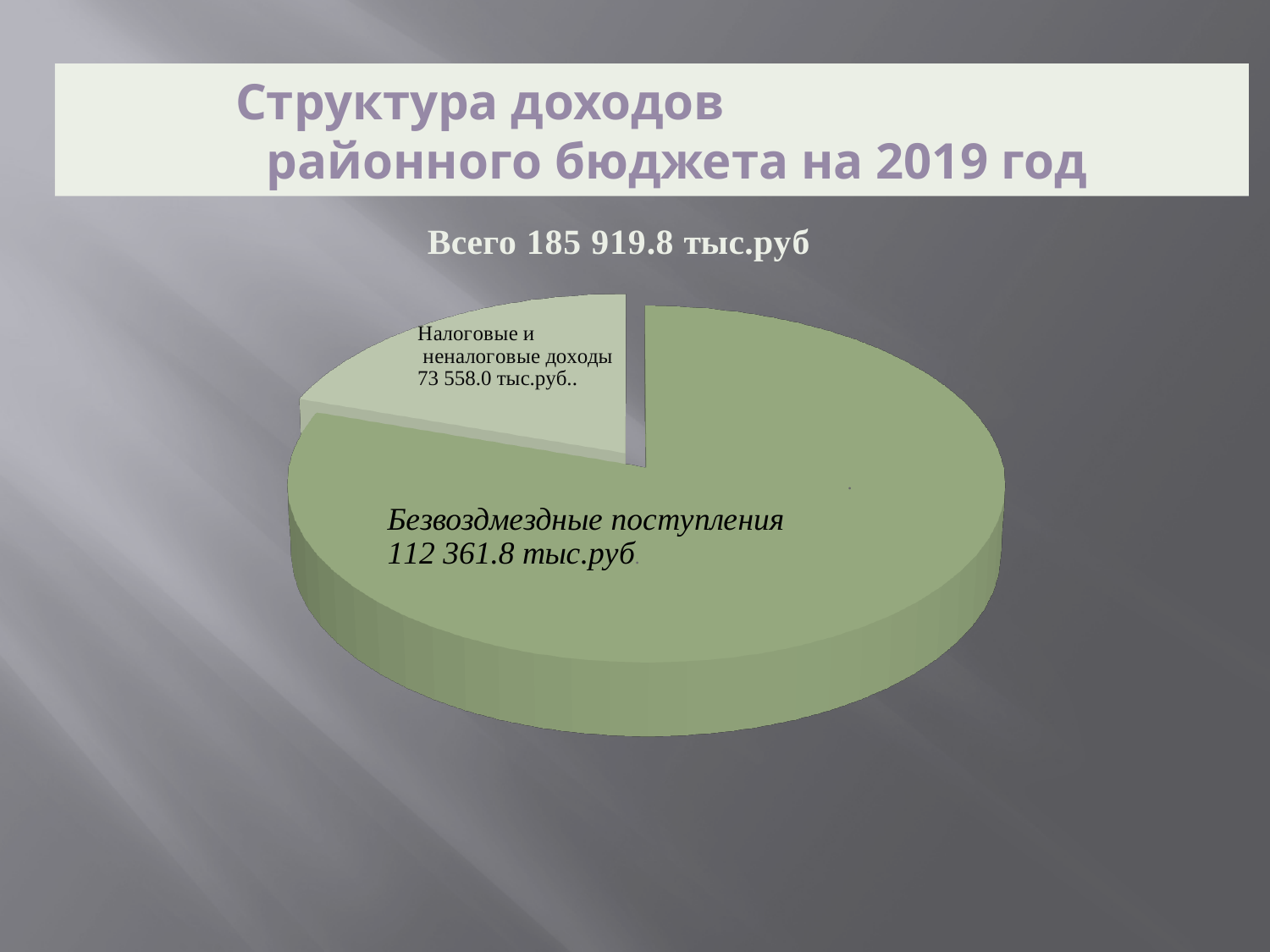
What is the difference between Безвоздмездные поступления and Налоговые и неналоговые доходы? 38 803.8 тыс.руб. What share of the total do Налоговые и неналоговые доходы represent? 39.6% Which is larger: Безвоздмездные поступления or Налоговые и неналоговые доходы? Безвоздмездные поступления Which category has the largest slice of the pie? Безвоздмездные поступления What is the total of all income shown on the slide? 185 919.8 тыс.руб. How many slices does the pie chart have? 2 What is the value for Безвоздмездные поступления? 112 361.8 тыс.руб. What share of the total do Безвоздмездные поступления represent? 60.4% What is the title of the slide? Структура доходов районного бюджета на 2019 год What is the value for Налоговые и неналоговые доходы? 73 558.0 тыс.руб. Which category has the smallest slice of the pie? Налоговые и неналоговые доходы What kind of chart is shown on the slide? Pie chart